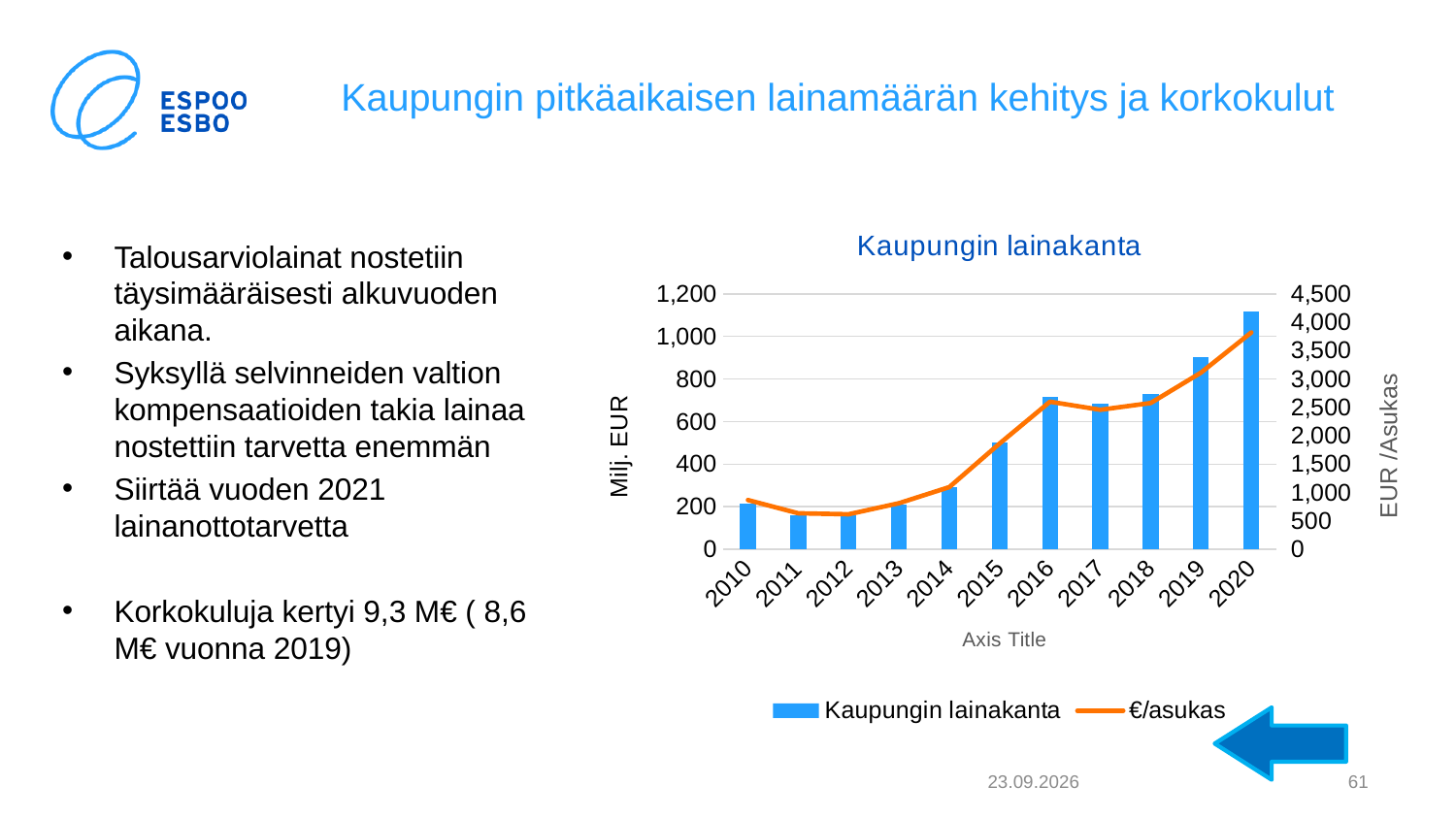
What is the title of the chart? Kaupungin lainakanta Does the Kaupungin lainakanta generally rise or fall from 2012 to 2020? rise Is the Kaupungin lainakanta value for 2019 greater or less than 800 Milj. EUR? greater Which is larger, the Kaupungin lainakanta value for 2010 or for 2020? 2020 Is the €/asukas value for 2020 greater or less than 3,500 EUR/Asukas? greater How many years are shown on the x axis of the chart? 11 Is the Kaupungin lainakanta value for 2011 greater or less than 200 Milj. EUR? less What type of chart is shown on the slide? Combined bar and line chart Which year has the highest value for Kaupungin lainakanta? 2020 How many series does the chart legend list? 2